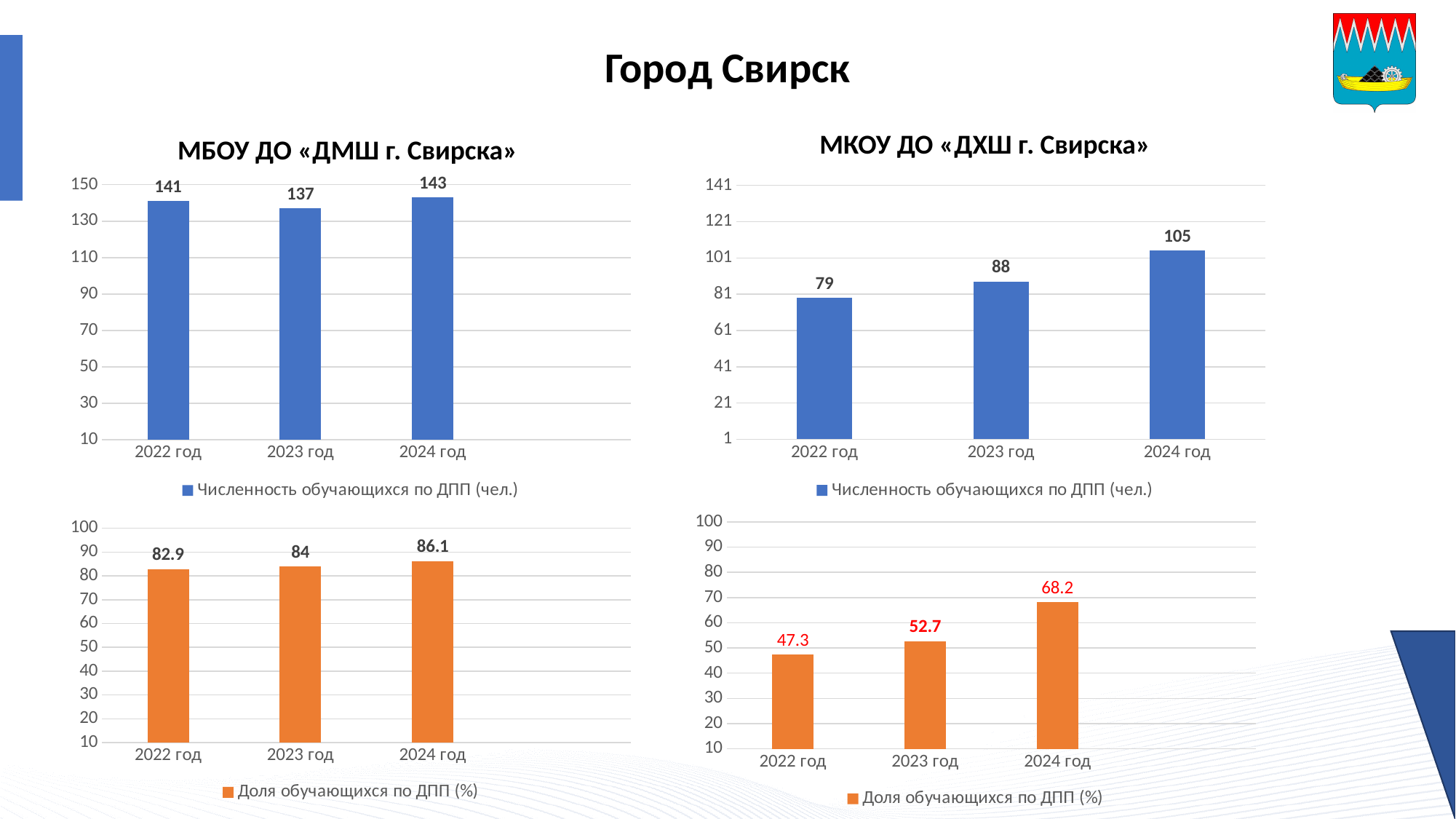
How many bars are in the bottom-right chart under «МКОУ ДО «ДХШ г. Свирска»»? 3 In the top-right chart under «МКОУ ДО «ДХШ г. Свирска»», do the values rise or fall from 2022 год to 2024 год? rise In the top-right chart under «МКОУ ДО «ДХШ г. Свирска»», what is the difference between the 2024 год and 2022 год values? 26 In the top-right chart under «МКОУ ДО «ДХШ г. Свирска»», what is the value for 2024 год? 105 In the top-left chart under «МБОУ ДО «ДМШ г. Свирска»», what is the value for 2023 год? 137 In the bottom-right chart (Доля обучающихся по ДПП (%)) under «МКОУ ДО «ДХШ г. Свирска»», what is the value for 2023 год? 52.7 Which is larger: the 2024 год value in the bottom-left chart (ДМШ share) or the 2024 год value in the bottom-right chart (ДХШ share)? bottom-left chart (86.1) What type of chart is the top-left chart under «МБОУ ДО «ДМШ г. Свирска»»? bar chart In the top-left chart under «МБОУ ДО «ДМШ г. Свирска»», what is the difference between the 2024 год and 2023 год values? 6 In the top-right chart under «МКОУ ДО «ДХШ г. Свирска»», which year has the lowest value? 2022 год In the top-left chart under «МБОУ ДО «ДМШ г. Свирска»», which year has the highest value? 2024 год In the bottom-left chart (Доля обучающихся по ДПП (%)) under «МБОУ ДО «ДМШ г. Свирска»», what is the value for 2022 год? 82.9